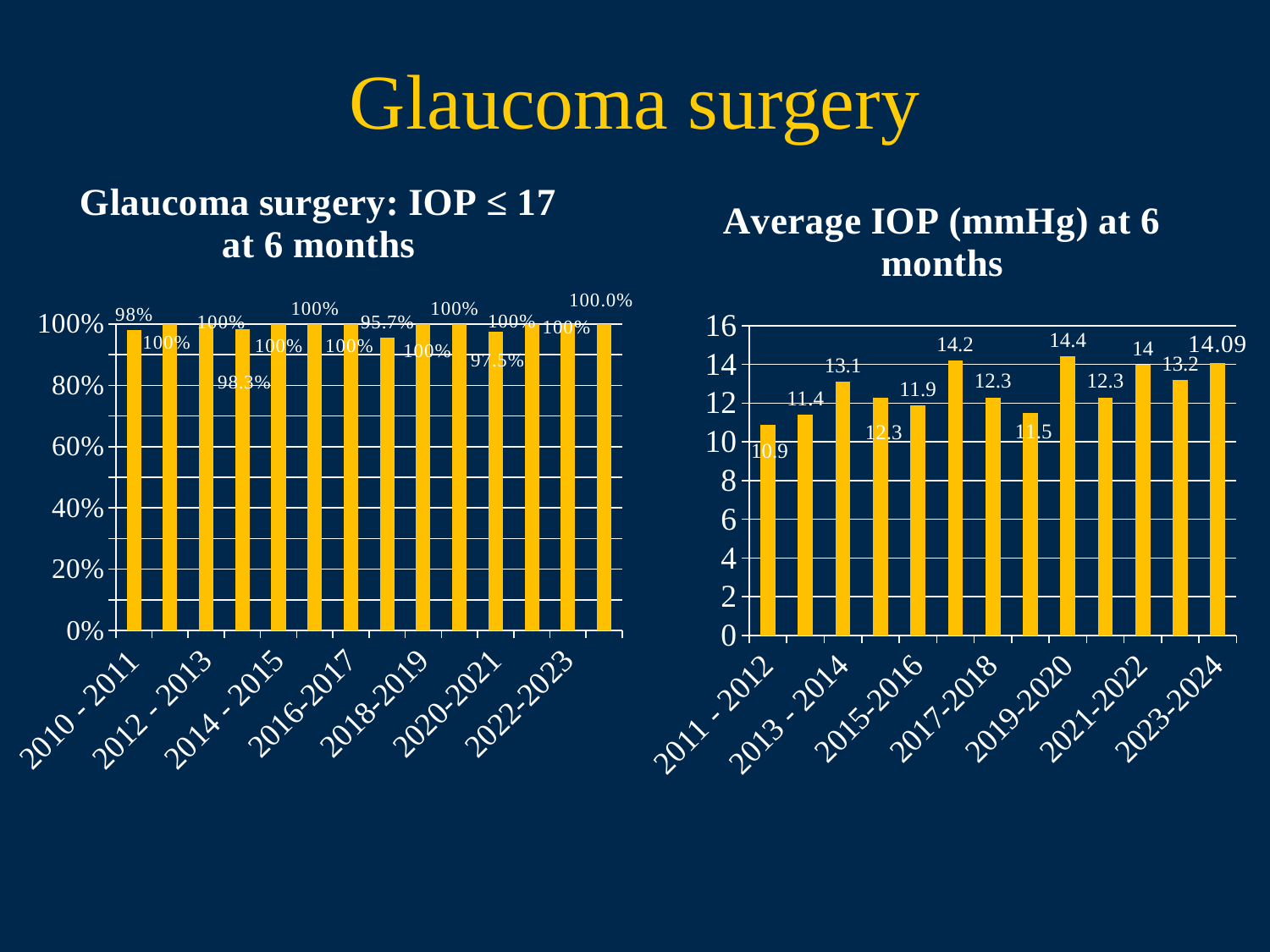
In the 'Average IOP (mmHg) at 6 months' chart, what is the value for 2021-2022? 14 In the 'Average IOP (mmHg) at 6 months' chart, what is the difference between the highest value (14.4) and the lowest value (10.9)? 3.5 In the 'Average IOP (mmHg) at 6 months' chart, what is the value for 2011 - 2012? 10.9 In the 'Average IOP (mmHg) at 6 months' chart, which period has the lowest average IOP? 2011 - 2012 In the 'Average IOP (mmHg) at 6 months' chart, how many bars are plotted? 13 In the 'Average IOP (mmHg) at 6 months' chart, which is larger: the value for 2013 - 2014 or the value for 2015-2016? 2013 - 2014 What kind of chart is 'Glaucoma surgery: IOP ≤ 17 at 6 months'? Bar chart In the 'Glaucoma surgery: IOP ≤ 17 at 6 months' chart, what is the value for 2010 - 2011? 98% In the 'Average IOP (mmHg) at 6 months' chart, what is the value for 2023-2024? 14.09 In the 'Glaucoma surgery: IOP ≤ 17 at 6 months' chart, what is the lowest value shown on any bar? 95.7% In the 'Average IOP (mmHg) at 6 months' chart, which period has the highest average IOP? 2019-2020 In the 'Glaucoma surgery: IOP ≤ 17 at 6 months' chart, is the value for 2010 - 2011 greater or less than 80%? greater